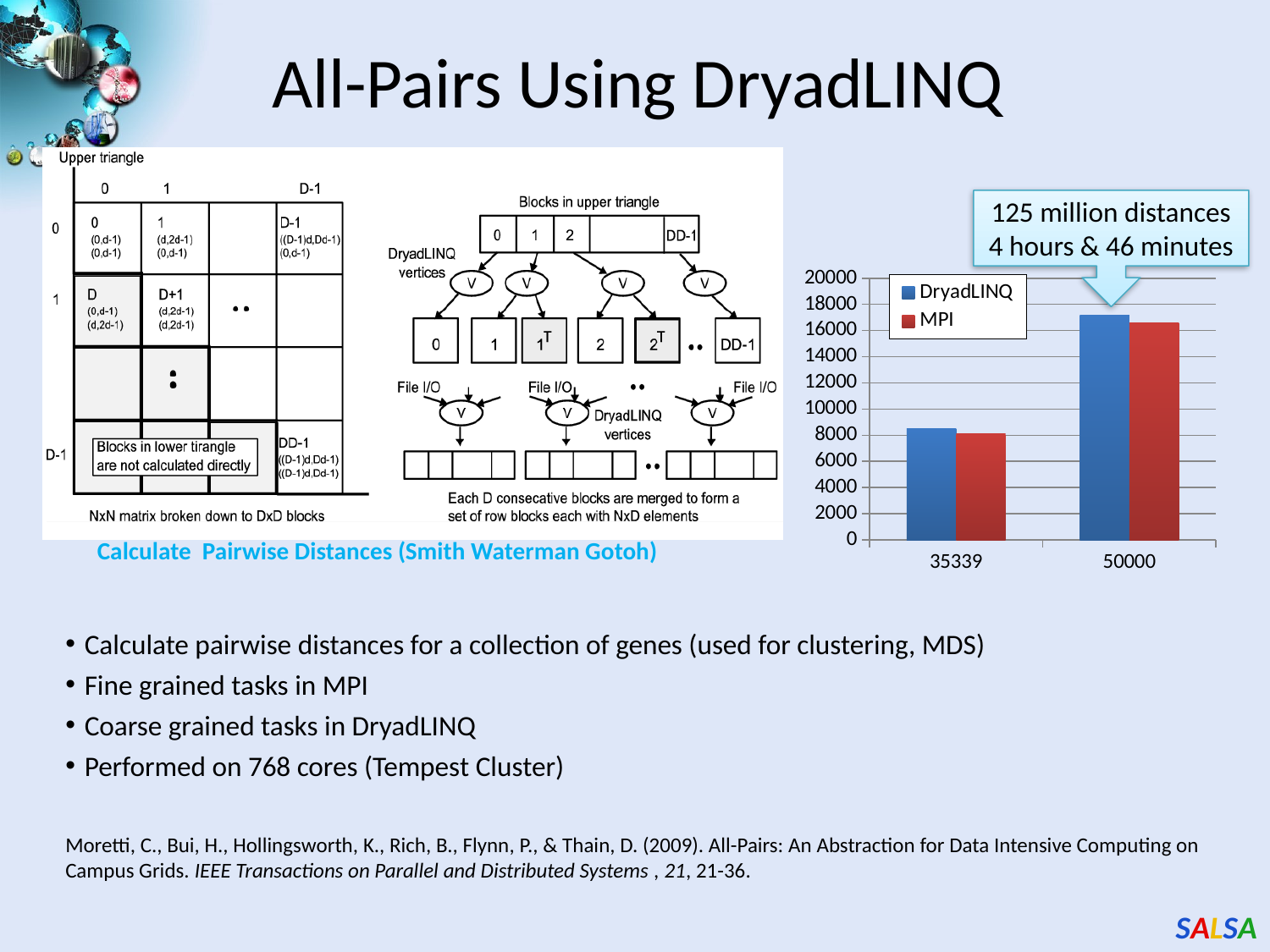
In the bar chart, is the DryadLINQ value for 50000 greater or less than 16000? greater In the bar chart, do the values rise or fall from the 35339 category to the 50000 category? rise In the bar chart, which series has the tallest bar overall? DryadLINQ In the bar chart, is the DryadLINQ value for 35339 greater or less than 10000? less In the bar chart, for the 50000 category, which series has the larger value, DryadLINQ or MPI? DryadLINQ Which two series are listed in the legend of the bar chart? DryadLINQ and MPI How many series does the legend of the bar chart list? 2 What kind of chart is shown on the right side of the slide? bar chart In the bar chart, is the MPI value for 50000 greater or less than 18000? less In the bar chart, which category has the lower values for both series? 35339 What are the two category labels on the x axis of the bar chart? 35339 and 50000 How many categories are shown on the x axis of the bar chart? 2